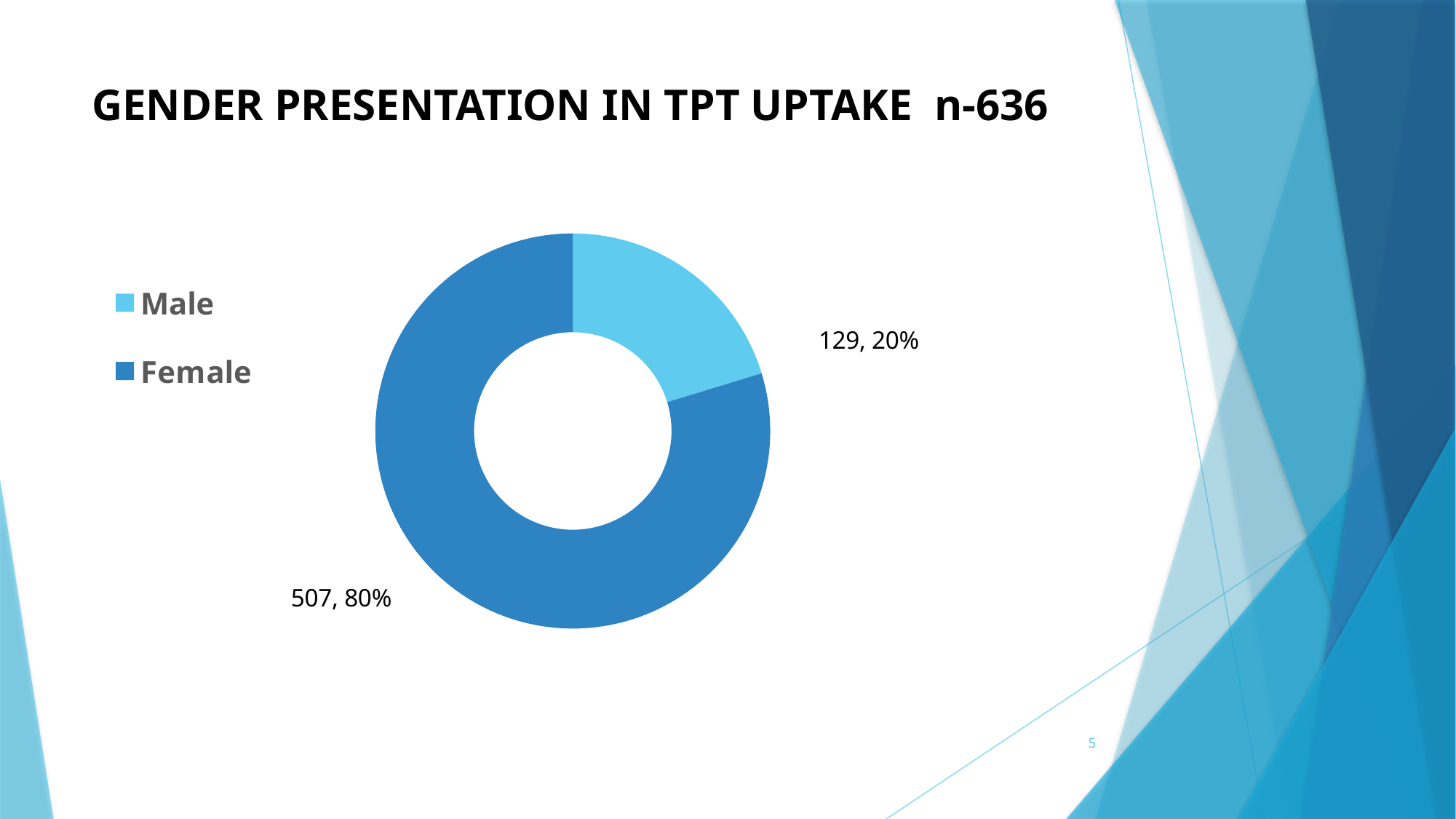
What is the total of the Male and Female counts? 636 What is the title of the slide? GENDER PRESENTATION IN TPT UPTAKE n-636 What is the count for Male? 129 Which category has the largest share? Female What percentage share does Female have? 80% How many categories does the chart show? 2 What is the difference between the Female and Male counts? 378 What is the count for Female? 507 Which is larger, the Male count or the Female count? Female Which category has the smallest share? Male What kind of chart is shown on the slide? Doughnut chart What percentage share does Male have? 20%